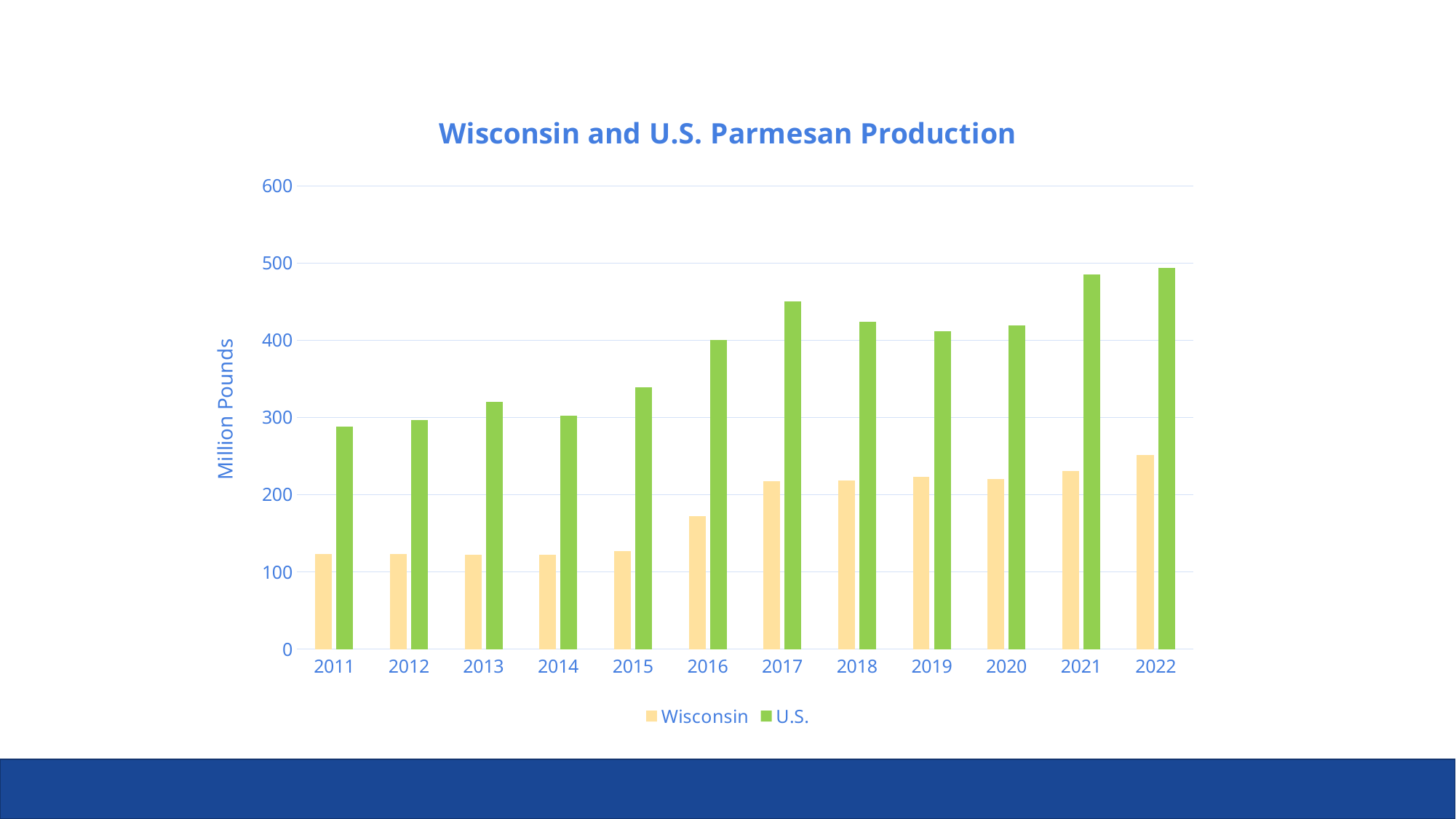
Is the Wisconsin value for 2016 greater or less than 200? less Which is larger, the U.S. value for 2017 or the U.S. value for 2018? 2017 What kind of chart is shown on the slide? bar chart How many years are shown on the x axis? 12 Is the U.S. value for 2011 greater or less than 300? less How many series does the legend list? 2 Do the U.S. values generally rise or fall from 2011 to 2022? rise Which year has the highest Wisconsin value? 2022 What is the label on the vertical axis? Million Pounds Is the U.S. value for 2017 greater or less than 400? greater Which is larger, the Wisconsin value for 2016 or the Wisconsin value for 2017? 2017